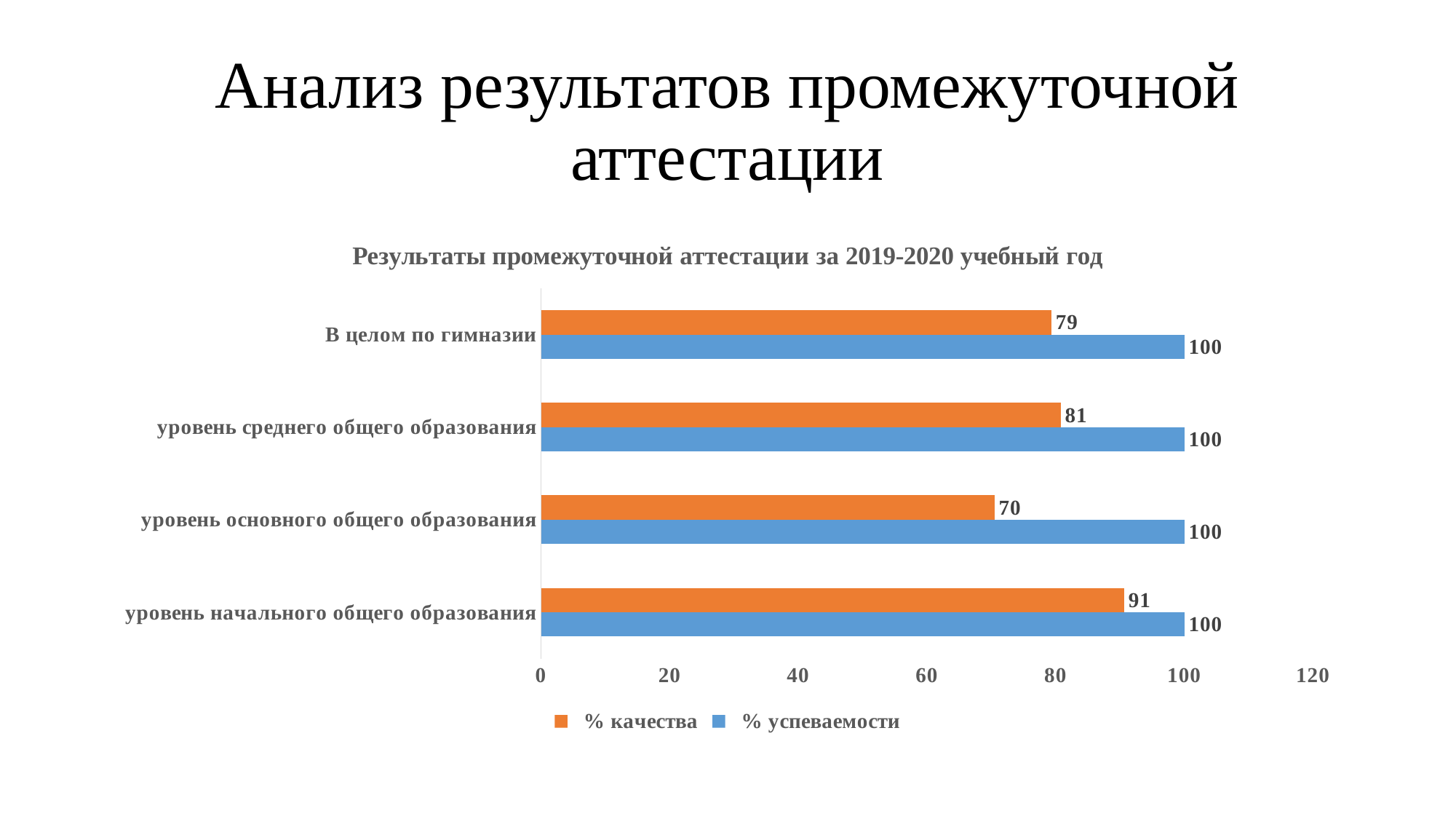
What is the % качества value for уровень начального общего образования? 91 Which category has the lowest % качества? уровень основного общего образования What is the % качества value for уровень основного общего образования? 70 What is the % качества value for уровень среднего общего образования? 81 What kind of chart is shown on the slide? bar chart Which is larger: % качества for уровень среднего общего образования or for В целом по гимназии? уровень среднего общего образования How many categories are shown on the chart? 4 Which category has the highest % качества? уровень начального общего образования What is the % качества value for В целом по гимназии? 79 What is the difference between % успеваемости and % качества for уровень основного общего образования? 30 How many series does the legend list? 2 What is the % успеваемости value for В целом по гимназии? 100